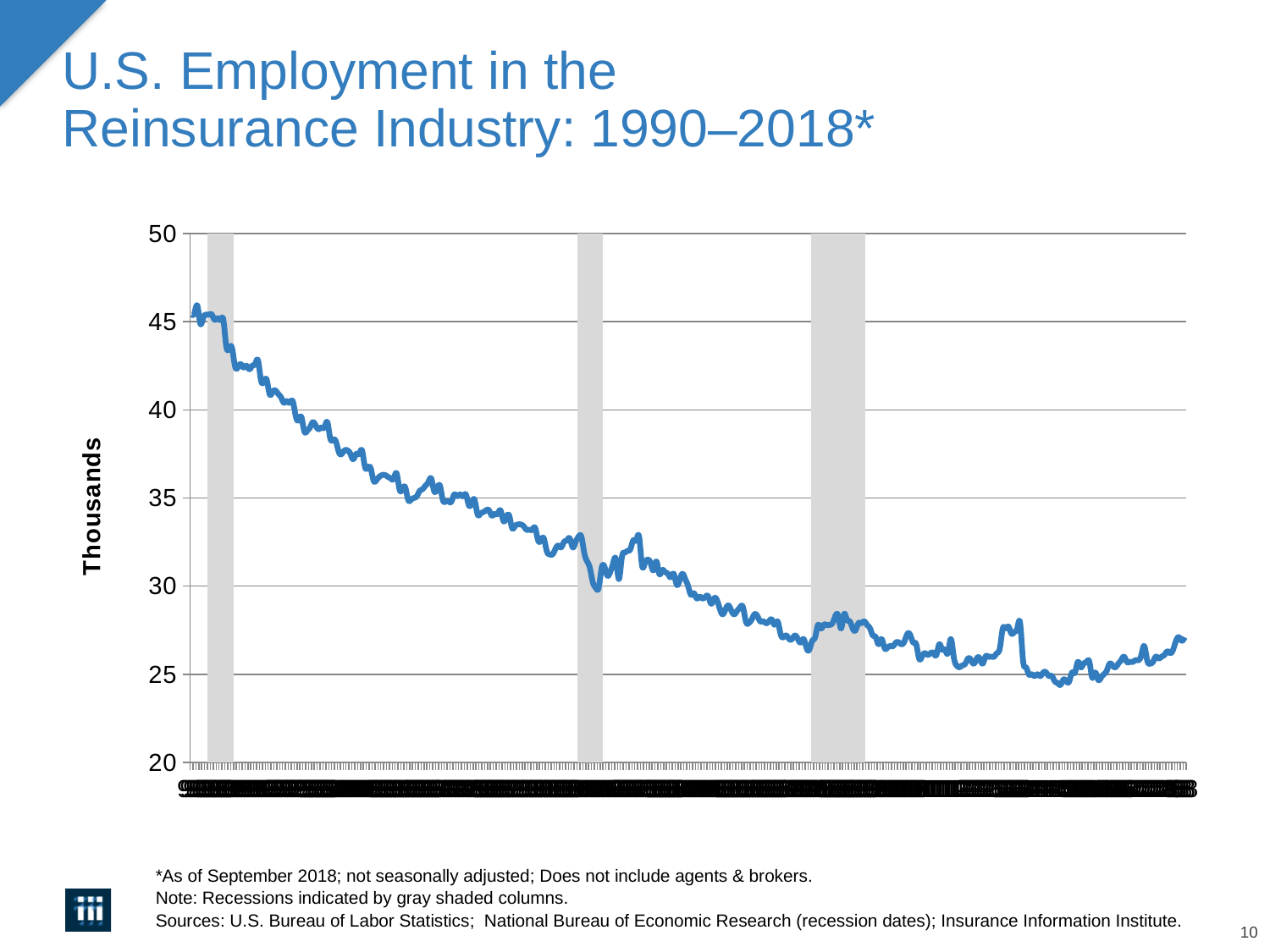
Which is larger: the value at the start of the series or the value at the end of the series? the start of the series Is the value at the end of the series (right end of the line) greater or less than 25? greater What is the label on the vertical axis? Thousands Does the line ever rise above 45 after the first gray shaded column? no How many gray shaded recession columns appear on the chart? 3 Is the value at the end of the series (right end of the line) greater or less than 30? less What kind of chart is shown on the slide? line chart What is the highest value shown on the vertical axis? 50 How many data series are plotted on the chart? 1 Overall, do the values rise or fall from the left to the right of the chart? fall